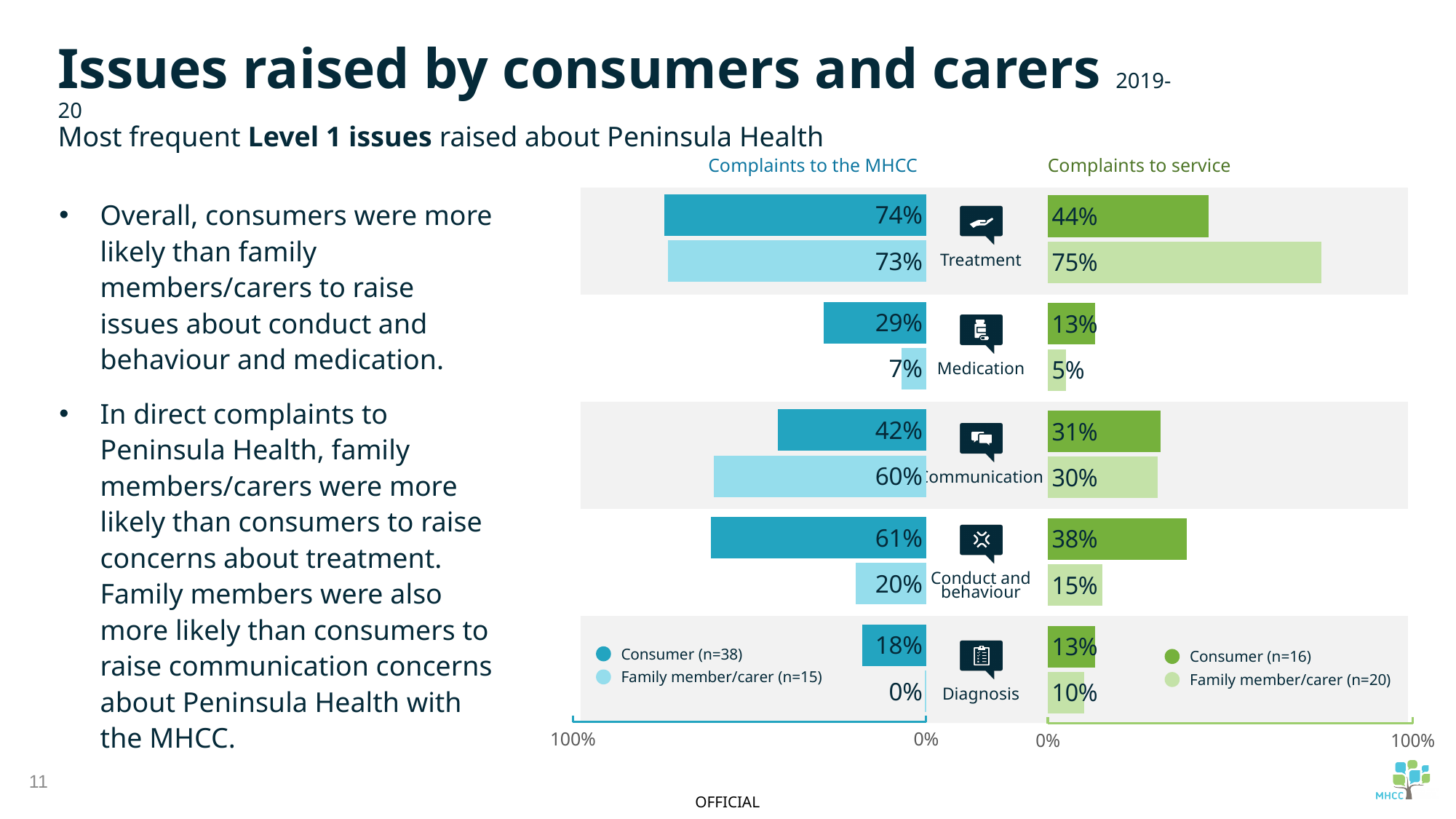
In the 'Complaints to the MHCC' chart, which is larger for Medication: the consumer value or the family member/carer value? Consumer In the 'Complaints to the MHCC' chart, what percentage of consumers raised issues about Treatment? 74% In the 'Complaints to service' chart, what is the value for consumers for Conduct and behaviour? 38% In the 'Complaints to the MHCC' chart, what is the difference between the consumer and family member/carer percentages for Conduct and behaviour? 41% In the 'Complaints to service' chart, what is the difference between the family member/carer and consumer percentages for Treatment? 31% In the 'Complaints to service' chart, what percentage of family members/carers raised issues about Treatment? 75% How many issue categories are shown in the 'Complaints to service' chart? 5 How many series does the legend of the 'Complaints to the MHCC' chart list? 2 In the 'Complaints to the MHCC' chart, which issue has the lowest family member/carer percentage? Diagnosis In the 'Complaints to the MHCC' chart, what is the value for family members/carers for Communication? 60% What type of chart is the 'Complaints to service' chart? Bar chart In the 'Complaints to the MHCC' chart, which issue has the highest consumer percentage? Treatment